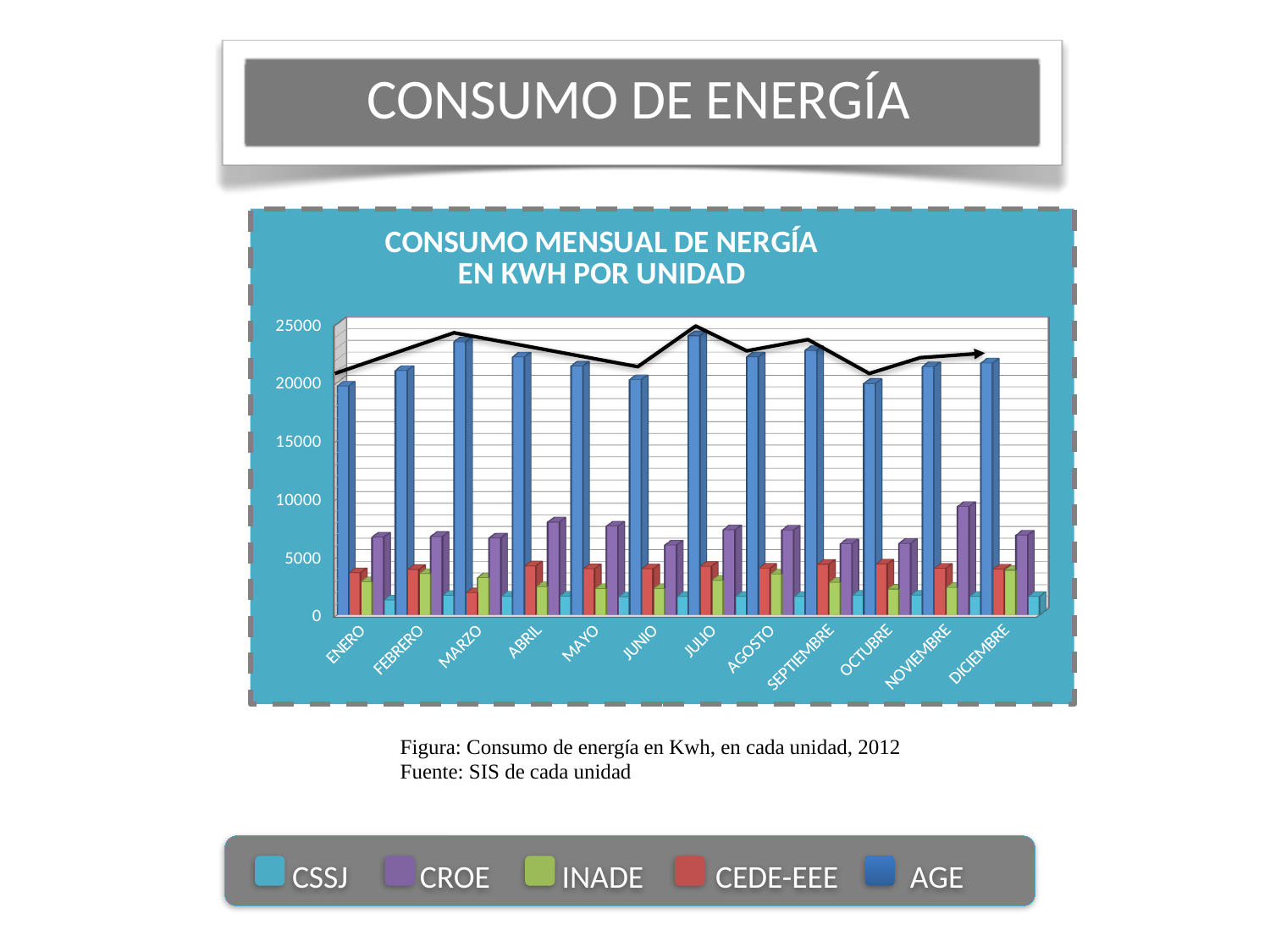
In ENERO, which is larger, the value for CROE or the value for INADE? CROE How many series does the legend list? 5 How many months are shown along the x axis of the chart? 12 In MARZO, which is larger, the value for AGE or the value for CROE? AGE Which series has the tallest bars in every month? AGE Is the value for CROE in NOVIEMBRE greater or less than 5000? greater Is the value for CSSJ in ENERO greater or less than 5000? less In which month is the CROE value highest? NOVIEMBRE Is the value for CEDE-EEE in SEPTIEMBRE greater or less than 10000? less What is the title of the chart? CONSUMO MENSUAL DE NERGÍA EN KWH POR UNIDAD What kind of chart is shown on the slide? Bar chart